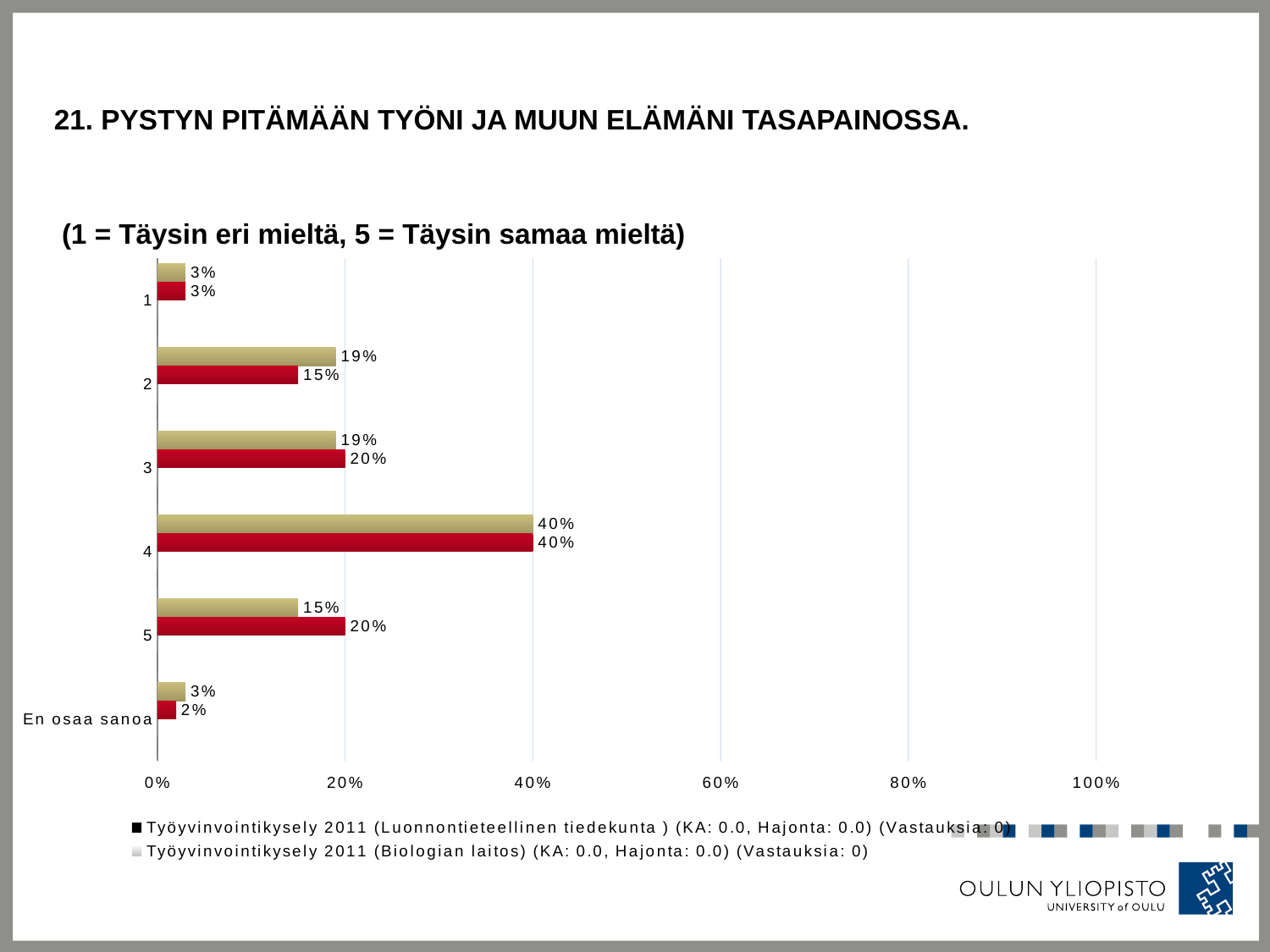
Which category has the highest value for the red bars? 4 How many series does the chart legend list? 2 What is the value of the tan bar for 'En osaa sanoa'? 3% How many categories are shown on the vertical axis of the chart? 6 Is the value of the red bar for category 4 greater or less than 20%? greater What is the title of the chart on the slide? 21. PYSTYN PITÄMÄÄN TYÖNI JA MUUN ELÄMÄNI TASAPAINOSSA. For category 2, which bar is larger, the tan bar or the red bar? the tan bar What is the value of the tan bar for category 2? 19% What is the value of the red bar for category 5? 20% For category 5, what is the difference between the red bar (20%) and the tan bar (15%)? 5% What is the value of the red bar for category 4? 40% What kind of chart is shown on the slide? bar chart